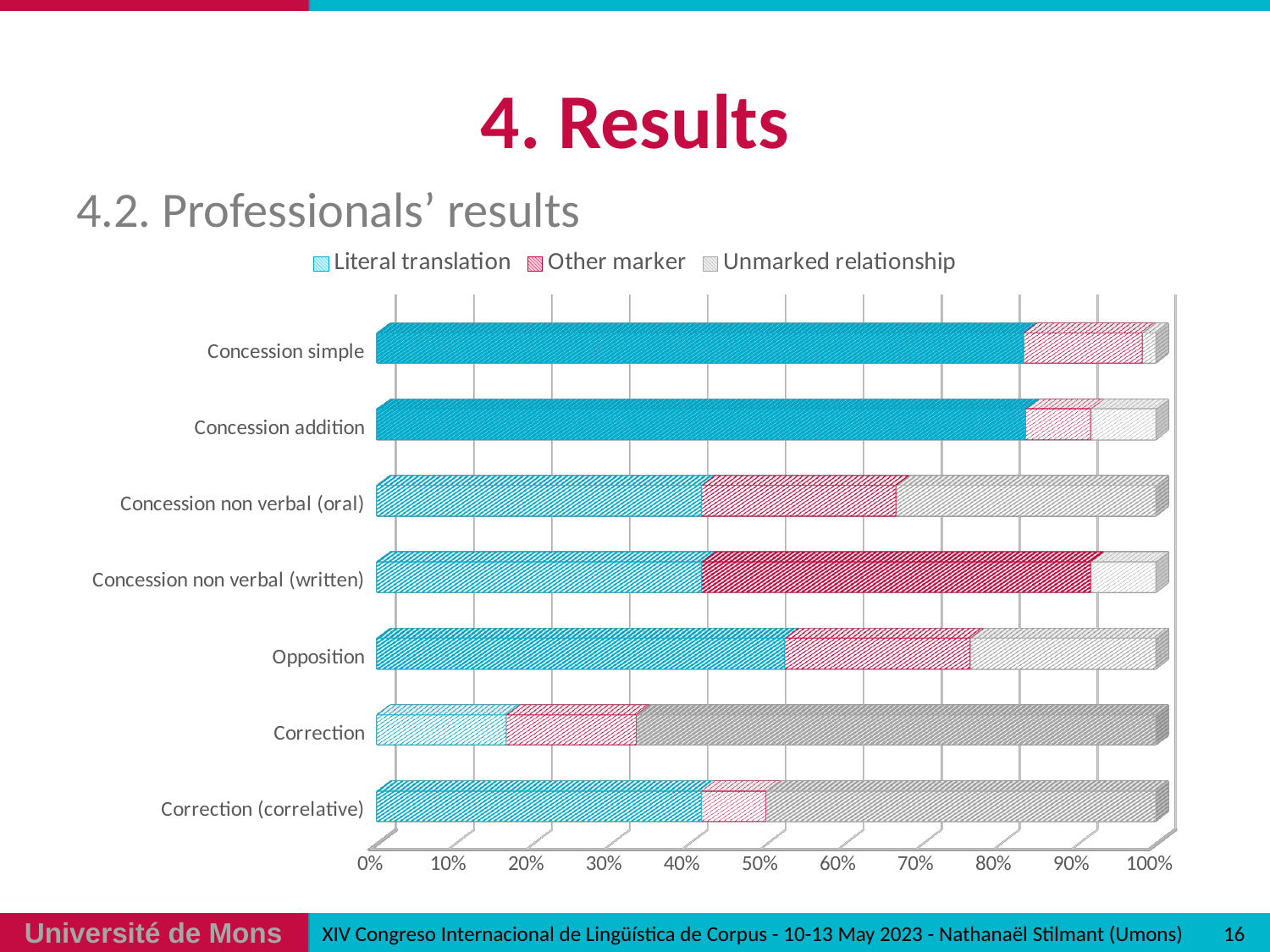
How many categories are plotted on the chart? 7 Which has the larger Other marker share, Concession non verbal (written) or Concession addition? Concession non verbal (written) Is the Literal translation share for Concession non verbal (oral) greater or less than 60%? less Which category has the lowest Literal translation share? Correction Which series is shown in blue in the legend? Literal translation Is the Literal translation share for Concession simple greater or less than 70%? greater How many series does the legend list? 3 Which has the larger Literal translation share, Opposition or Correction? Opposition Which category has the largest Other marker share? Concession non verbal (written) Is the Literal translation share for Correction greater or less than 30%? less Which category has the largest Unmarked relationship share? Correction What kind of chart is shown on the slide? stacked bar chart